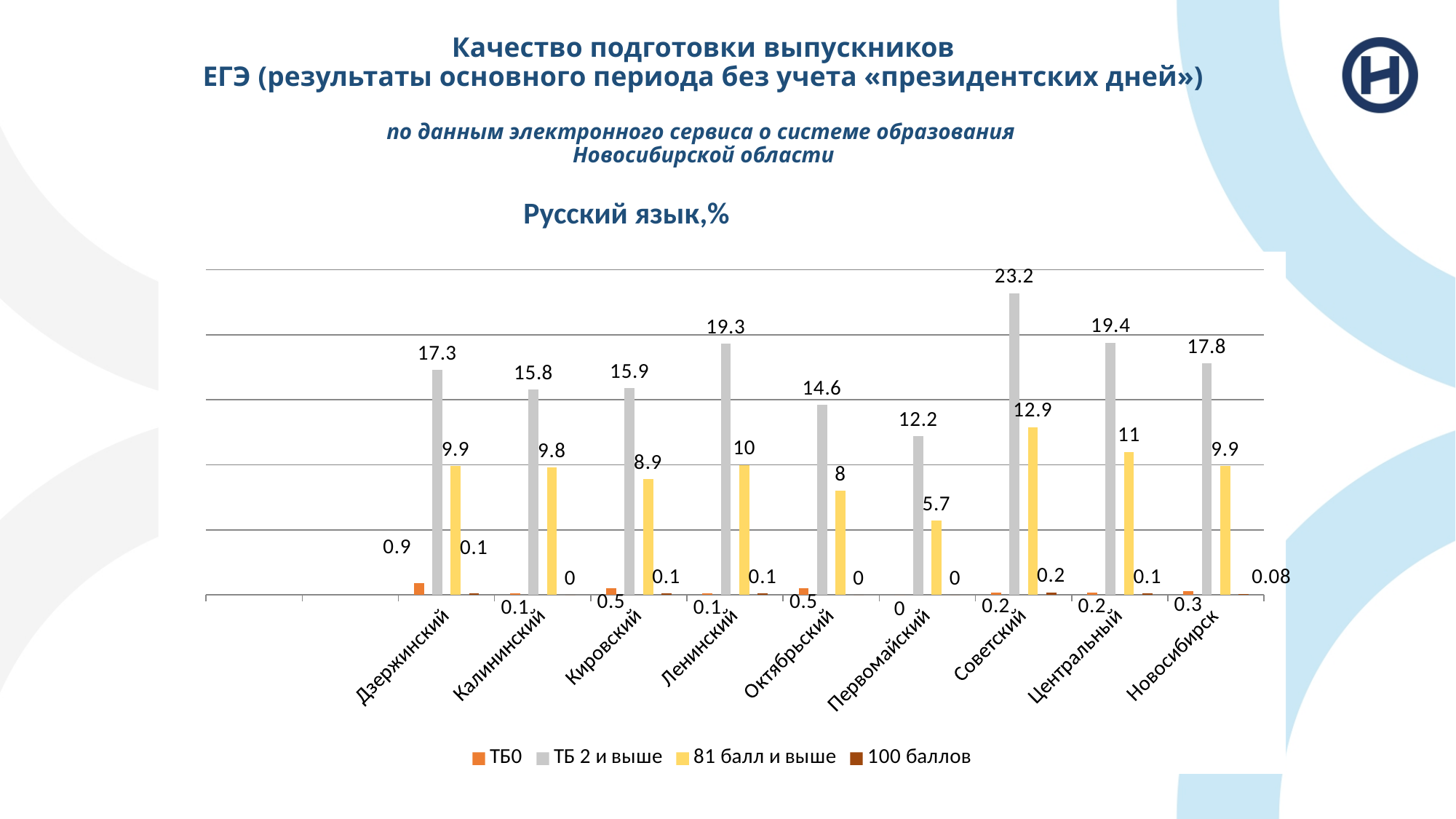
What is the difference between the 'ТБ 2 и выше' values for Советский and Первомайский? 11 How many series does the legend list? 4 Which category has the highest value for 'ТБ 2 и выше'? Советский Which category has the lowest value for '81 балл и выше'? Первомайский What is the value of 'ТБ0' for Дзержинский? 0.9 What is the value of '100 баллов' for Новосибирск? 0.08 What is the title of the chart? Русский язык,% What is the value of '81 балл и выше' for Первомайский? 5.7 How many categories are shown on the x axis? 9 What is the value of 'ТБ 2 и выше' for Советский? 23.2 Which is larger: the '81 балл и выше' value for Центральный or for Ленинский? Центральный What kind of chart is shown? Bar chart